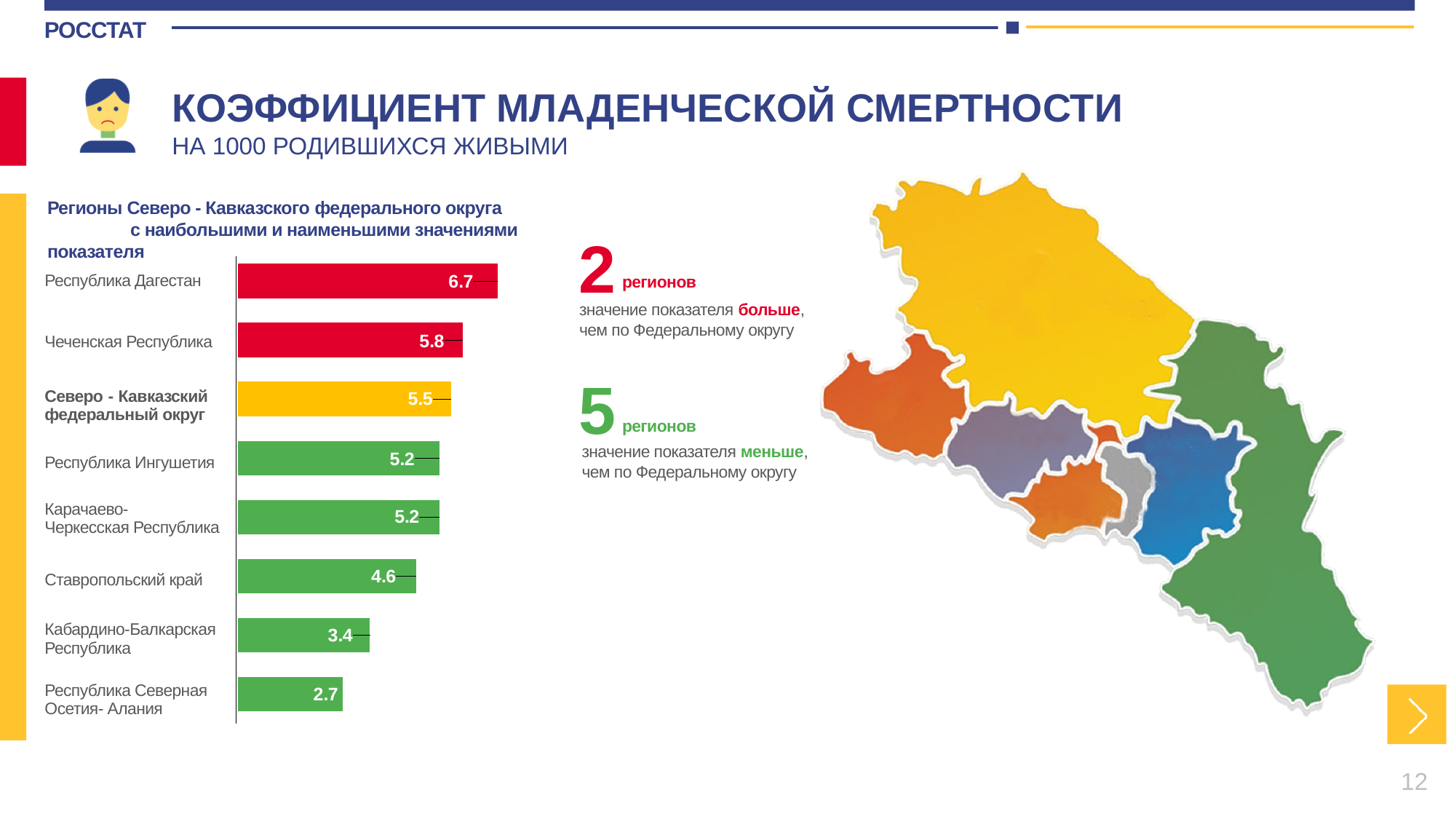
What type of chart is shown on the slide? Bar chart Which region has the lowest value on the chart? Республика Северная Осетия-Алания What colour is the bar for Северо-Кавказский федеральный округ? Yellow What value is shown for Ставропольский край? 4.6 How many bars are shown on the chart? 8 Which region has the highest value on the chart? Республика Дагестан What is the infant mortality rate shown for Республика Дагестан? 6.7 What value is shown for Северо-Кавказский федеральный округ? 5.5 What value is shown for Кабардино-Балкарская Республика? 3.4 What is the difference between the values for Республика Дагестан and Республика Северная Осетия-Алания? 4.0 What value is shown for Чеченская Республика? 5.8 Which has a larger value, Чеченская Республика or Ставропольский край? Чеченская Республика